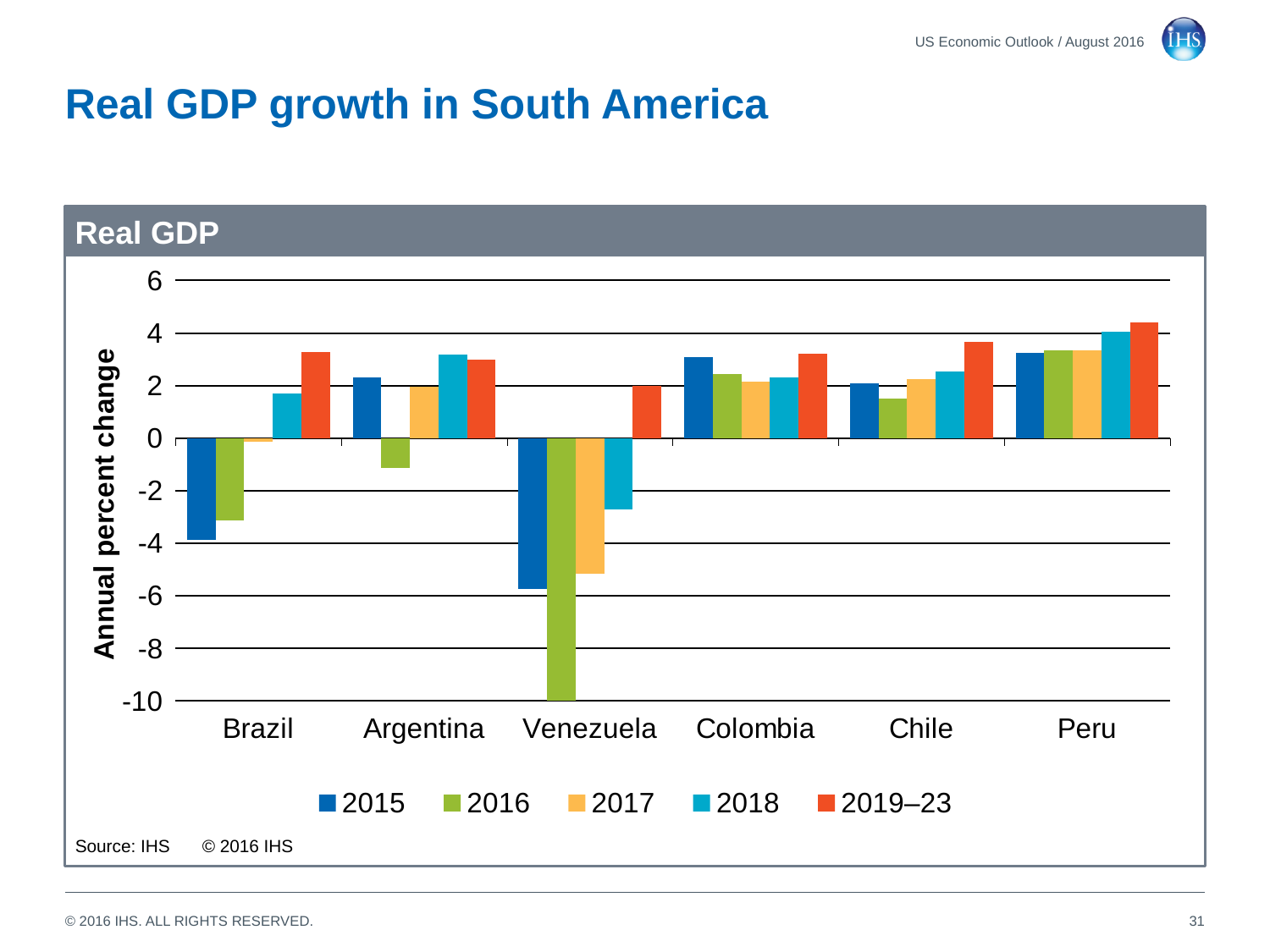
Is the value for Peru in 2019–23 greater or less than 4? greater Is the value for Brazil in 2015 greater or less than -2? less Do the values for Brazil rise or fall from 2015 through 2019–23? rise What kind of chart is shown on the slide? Bar chart How many countries are shown on the x axis? 6 What is the label on the vertical axis? Annual percent change Is the value for Venezuela in 2016 greater or less than -8? less Which is larger, the 2016 value for Argentina or the 2016 value for Chile? Chile Which country has the highest value for 2019–23? Peru Which country has the lowest value for 2016? Venezuela How many series does the legend list? 5 Which is larger, the 2018 value for Peru or the 2018 value for Colombia? Peru